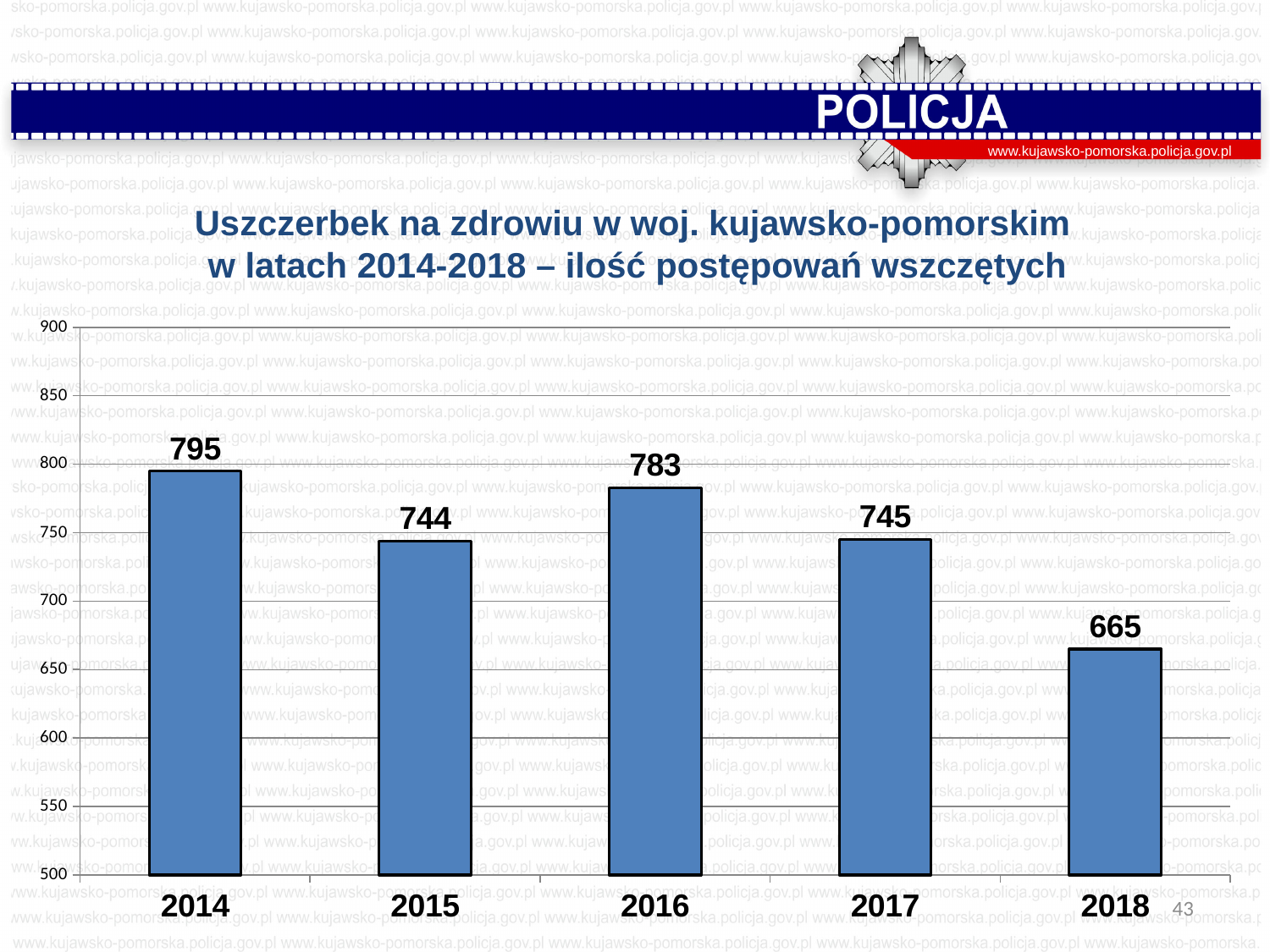
What is the difference between the values for 2016 and 2015? 39 Which is larger, the value for 2015 or the value for 2016? 2016 What is the title of the chart? Uszczerbek na zdrowiu w woj. kujawsko-pomorskim w latach 2014-2018 – ilość postępowań wszczętych How many years are shown on the chart? 5 What is the value for 2018? 665 Which year has the highest value? 2014 What is the value for 2014? 795 What is the difference between the values for 2014 and 2018? 130 Which year has the lowest value? 2018 What is the value for 2016? 783 Is the value for 2017 greater or less than 700? greater What kind of chart is shown on the slide? bar chart